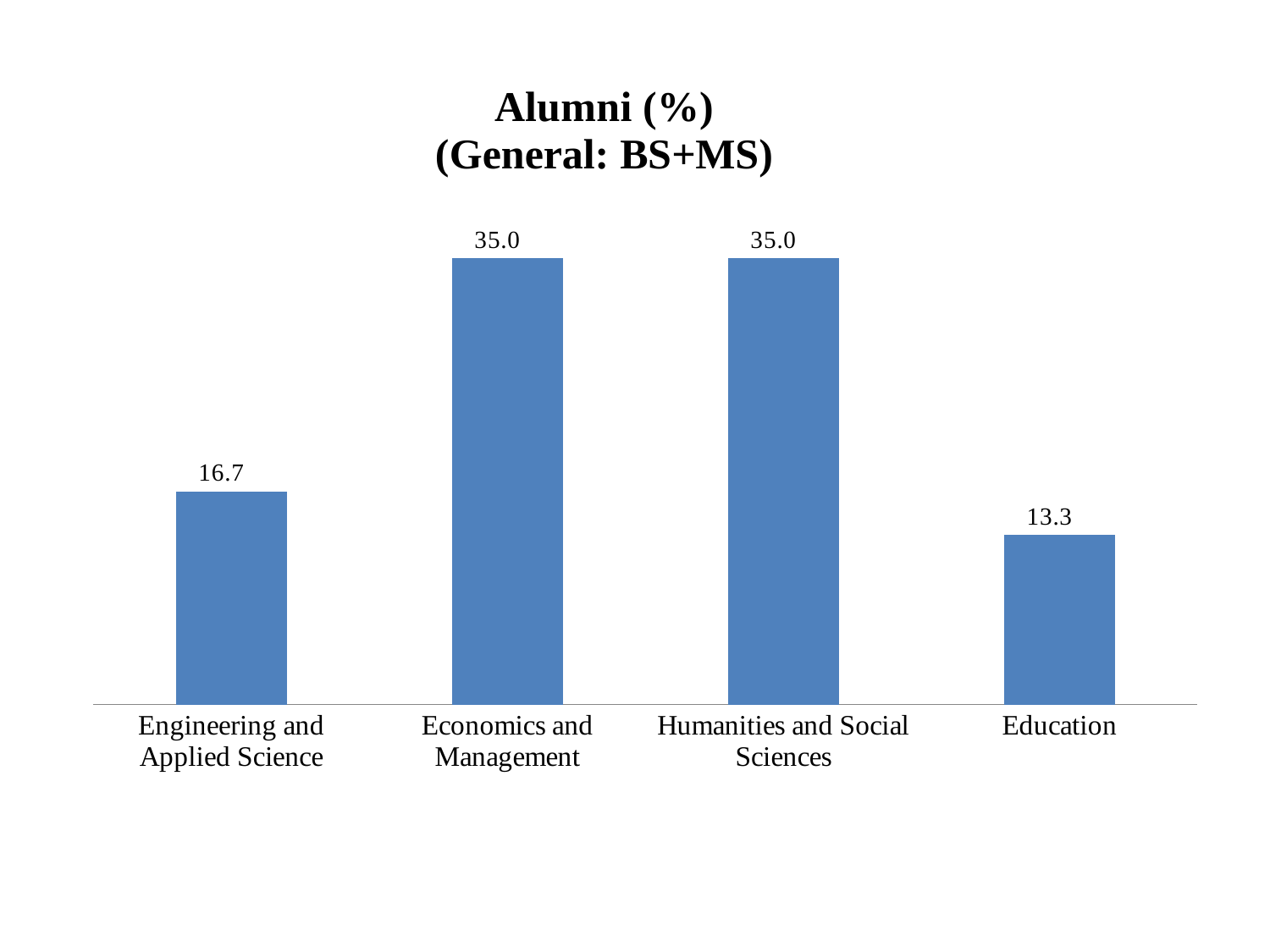
What is the value for Economics and Management? 35.0 What is the value for Engineering and Applied Science? 16.7 Which category has the lowest value? Education Which is larger, the value for Humanities and Social Sciences or the value for Education? Humanities and Social Sciences What is the value for Education? 13.3 What is the value for Humanities and Social Sciences? 35.0 What is the difference between the values for Engineering and Applied Science and Education? 3.4 Which is larger, the value for Engineering and Applied Science or the value for Education? Engineering and Applied Science What is the title of the chart? Alumni (%) (General: BS+MS) How many categories are shown in the chart? 4 What kind of chart is shown on the slide? Bar chart What is the difference between the values for Economics and Management and Engineering and Applied Science? 18.3